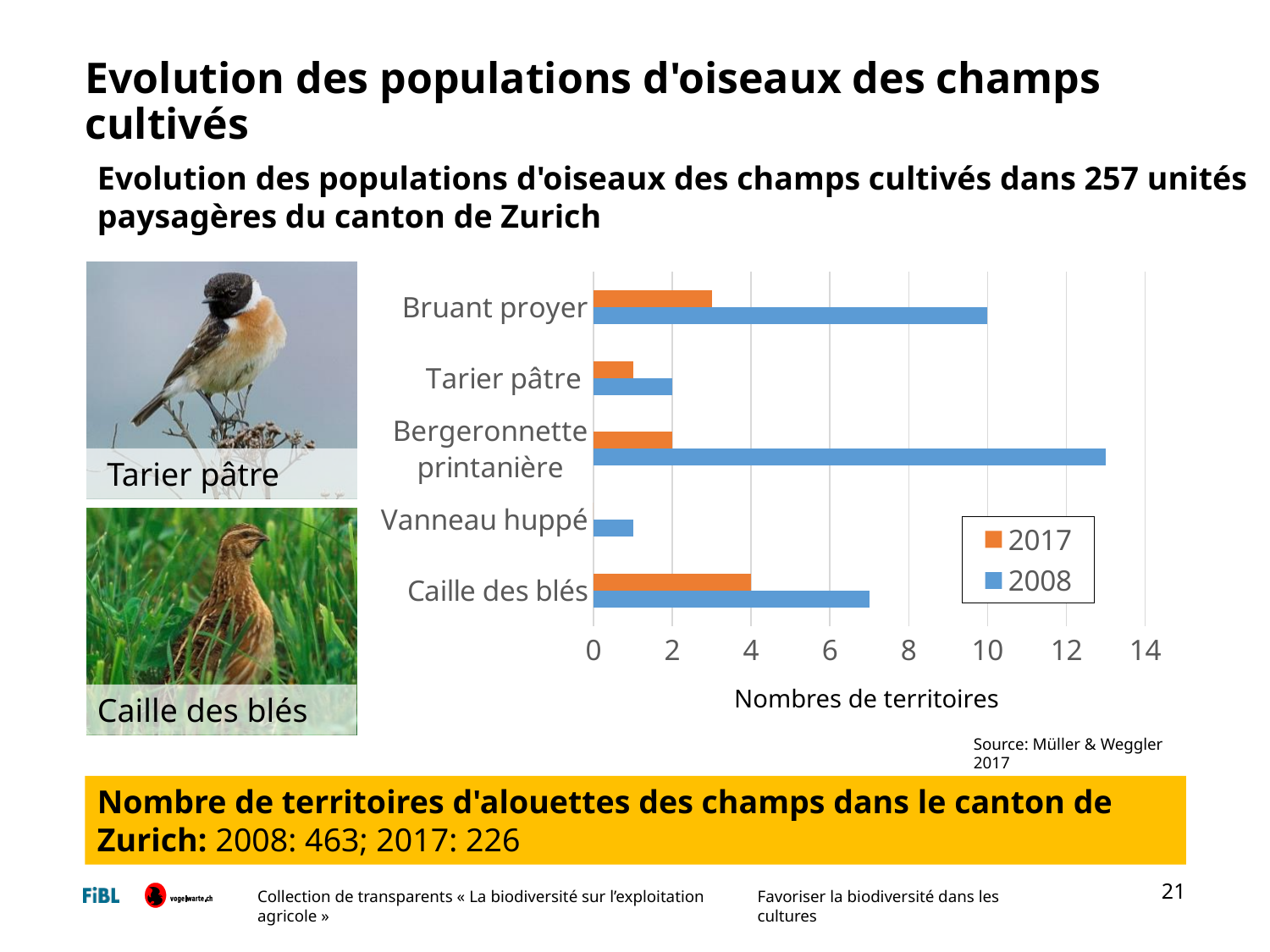
How many bird species (categories) are shown in the chart? 5 What is the 2008 value for Tarier pâtre? 2 Is the 2008 value for Bergeronnette printanière greater or less than 12? greater Which species has the highest 2008 value? Bergeronnette printanière Is the 2008 value for Caille des blés greater or less than 8? less What kind of chart is shown on the slide? bar chart What is the 2017 value for Bergeronnette printanière? 2 What is the title of the horizontal axis? Nombres de territoires How many series does the chart legend list? 2 What is the 2008 value for Bruant proyer? 10 Which species has the lowest 2008 value? Vanneau huppé What is the 2017 value for Caille des blés? 4